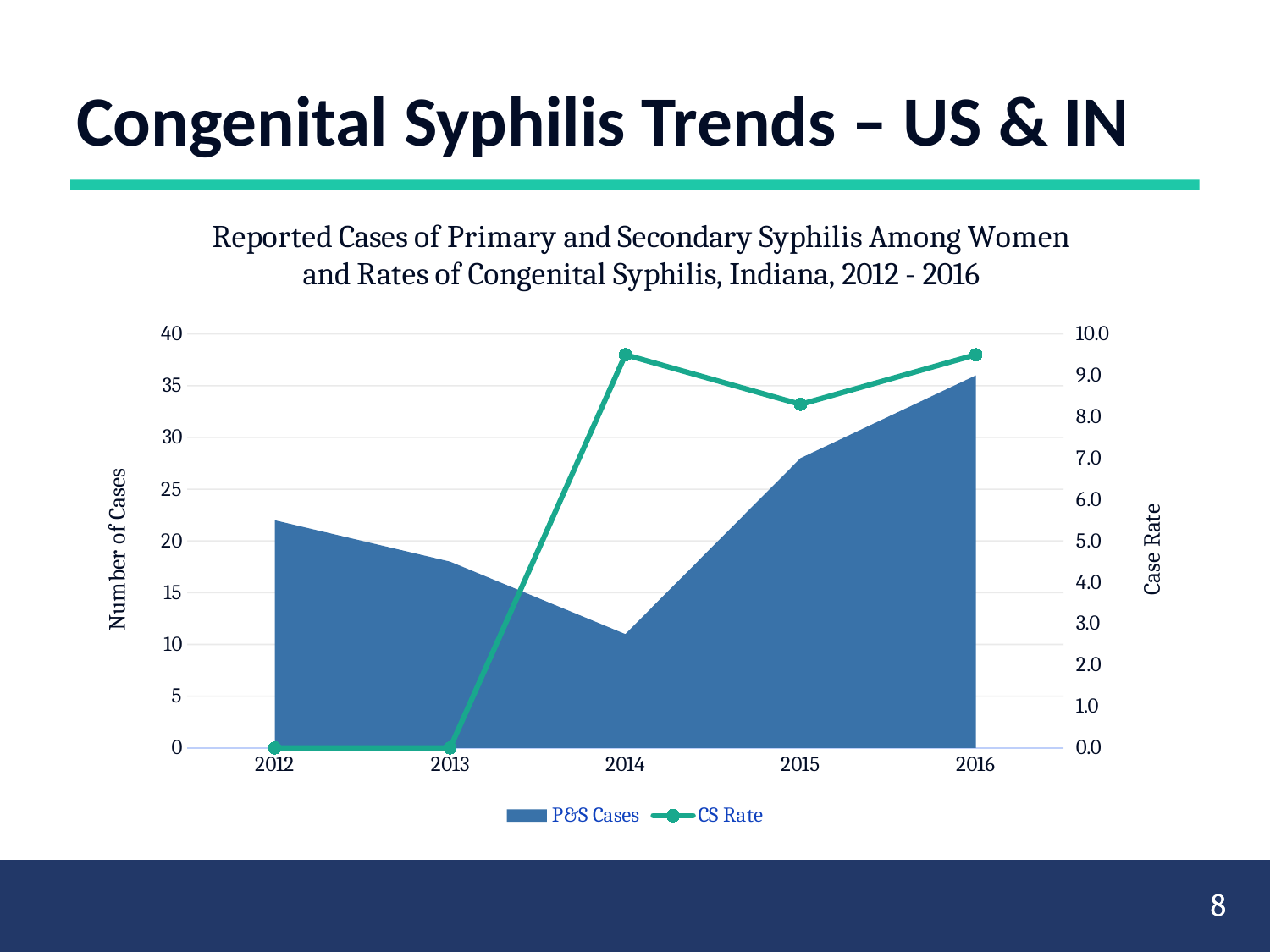
What is the CS Rate value for 2012? 0.0 What is the title of the right-hand vertical axis? Case Rate How many series does the legend list? 2 Do the P&S Cases rise or fall from 2014 to 2016? rise How many years are shown on the x axis? 5 In which year is the number of P&S Cases lowest? 2014 Which year has more P&S Cases, 2013 or 2015? 2015 Is the CS Rate in 2015 greater or less than 7.0? greater Is the number of P&S Cases in 2016 greater or less than 30? greater What is the CS Rate value for 2013? 0.0 Is the number of P&S Cases in 2014 greater or less than 15? less In which year is the number of P&S Cases highest? 2016